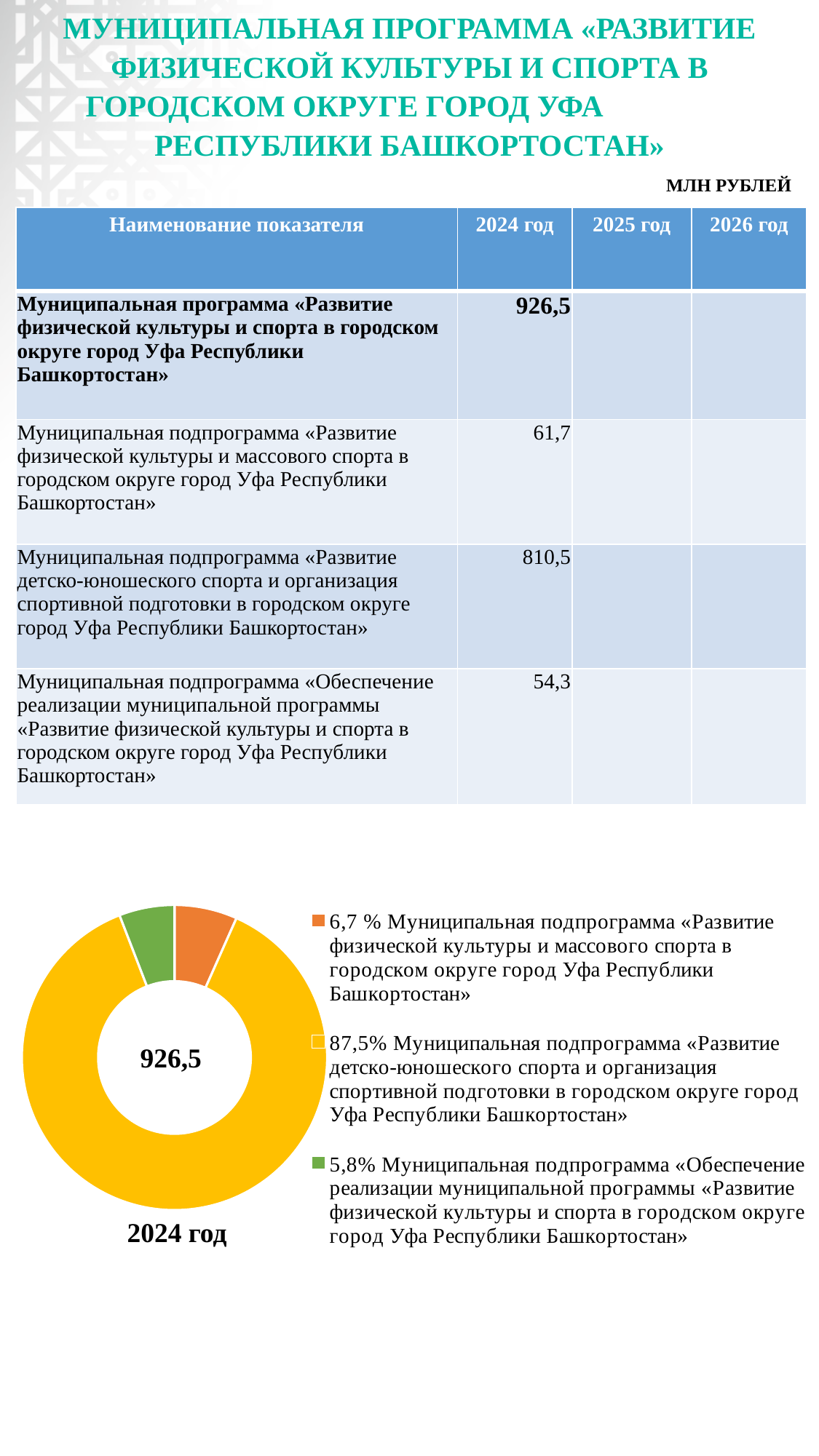
What share of the doughnut chart does the subprogram «Развитие физической культуры и массового спорта в городском округе город Уфа Республики Башкортостан» have? 6,7 % How many slices does the doughnut chart have? 3 Which subprogram has the smallest slice in the doughnut chart? Муниципальная подпрограмма «Обеспечение реализации муниципальной программы «Развитие физической культуры и спорта в городском округе город Уфа Республики Башкортостан» What share of the doughnut chart does the subprogram «Обеспечение реализации муниципальной программы «Развитие физической культуры и спорта в городском округе город Уфа Республики Башкортостан» have? 5,8% What year is labelled beneath the doughnut chart? 2024 год What kind of chart is shown at the bottom of the slide? Pie (doughnut) chart In the doughnut chart, which slice is larger: the one for «Развитие физической культуры и массового спорта» or the one for «Обеспечение реализации муниципальной программы»? «Развитие физической культуры и массового спорта» How many entries does the legend of the doughnut chart list? 3 Which subprogram has the largest slice in the doughnut chart? Муниципальная подпрограмма «Развитие детско-юношеского спорта и организация спортивной подготовки в городском округе город Уфа Республики Башкортостан» What total value is printed in the centre of the doughnut chart? 926,5 What share of the doughnut chart does the subprogram «Развитие детско-юношеского спорта и организация спортивной подготовки в городском округе город Уфа Республики Башкортостан» have? 87,5% What is the difference in percentage points between the 87,5% slice and the 6,7 % slice in the doughnut chart? 80,8